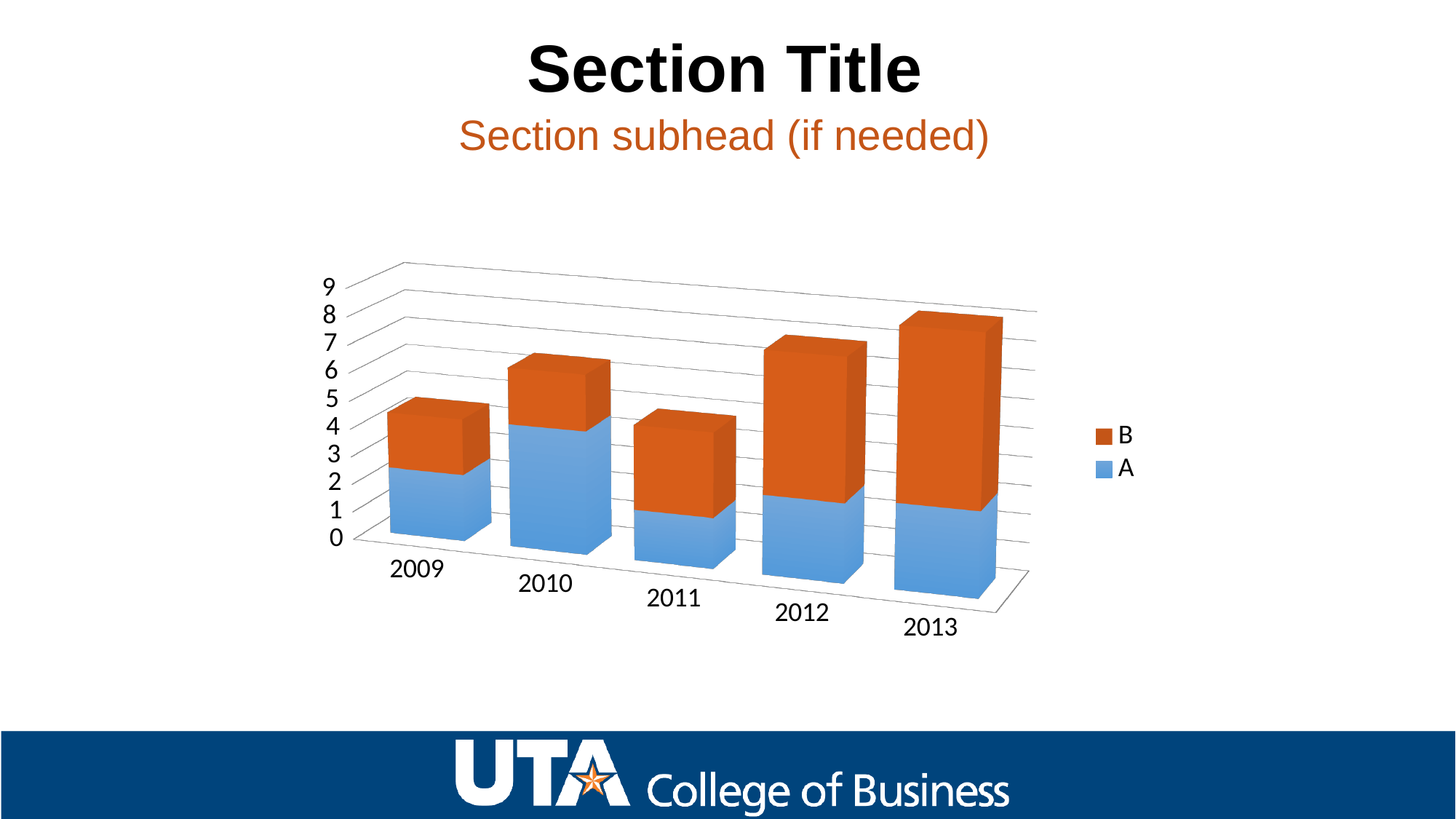
What colour represents series B in the chart? orange What kind of chart is shown on the slide? bar chart Which year has the lowest value for series A? 2011 Which year has the highest value for series A? 2010 How many categories (years) are shown on the x axis of the chart? 5 Which year has the highest value for series B? 2013 Which year has the tallest stacked bar overall? 2013 Is the total stacked value for 2013 greater or less than 6? greater Is the total stacked value for 2011 greater or less than 6? less How many series does the chart's legend list? 2 Which year has the larger total stacked bar, 2009 or 2013? 2013 Is the value of series A for 2010 greater or less than 2? greater